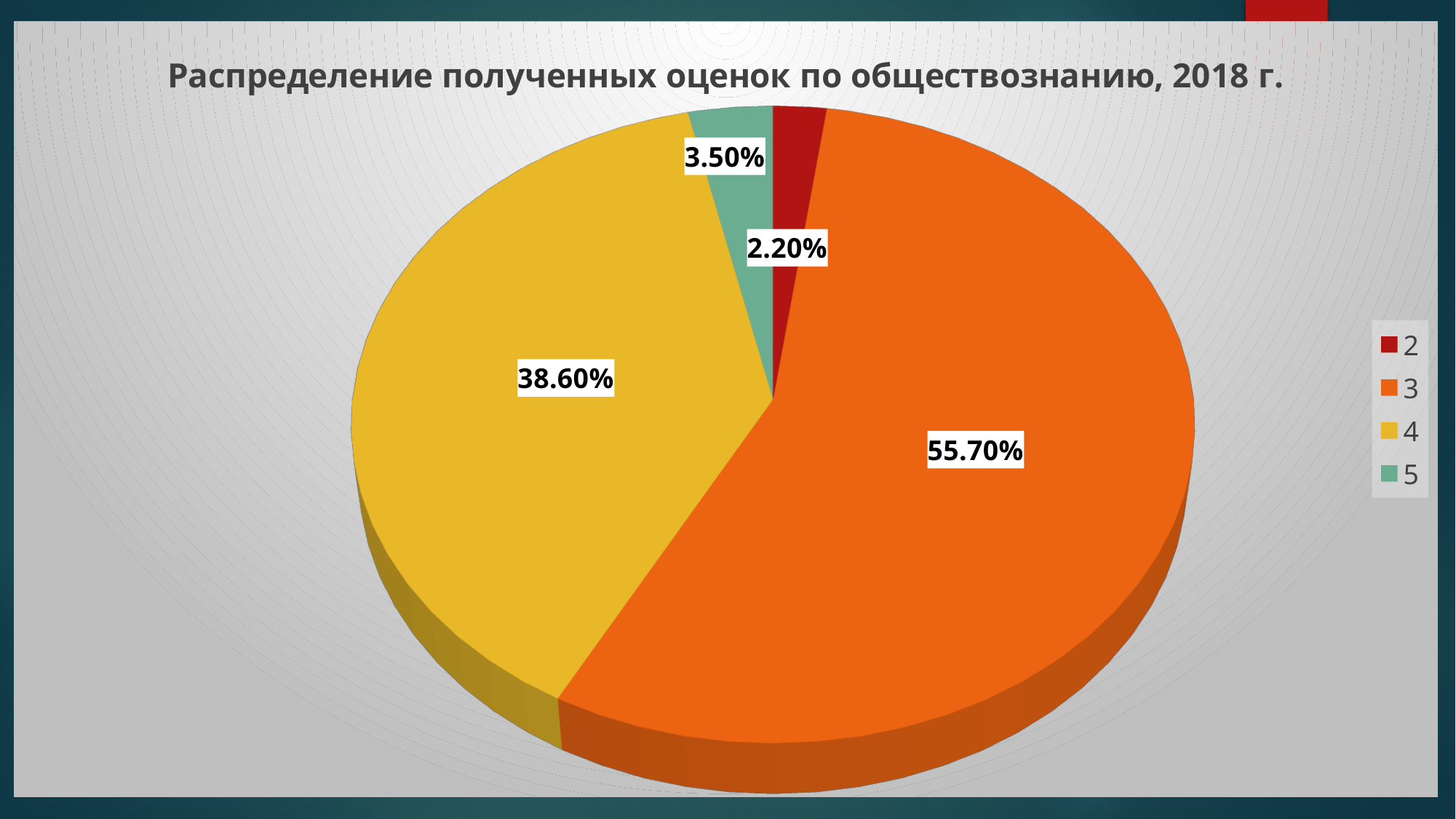
How many slices does the pie chart have? 4 What share of the pie does grade 3 have? 55.70% What is the difference in percentage points between the shares for grade 3 and grade 4? 17.10% Which colour represents grade 4 in the legend? yellow What share of the pie does grade 2 have? 2.20% Which grade has the smallest slice of the pie? 2 What kind of chart is shown on the slide? pie chart What share of the pie does grade 4 have? 38.60% What is the title of the chart? Распределение полученных оценок по обществознанию, 2018 г. Which grade has the largest slice of the pie? 3 Which is larger, the share for grade 5 or the share for grade 2? 5